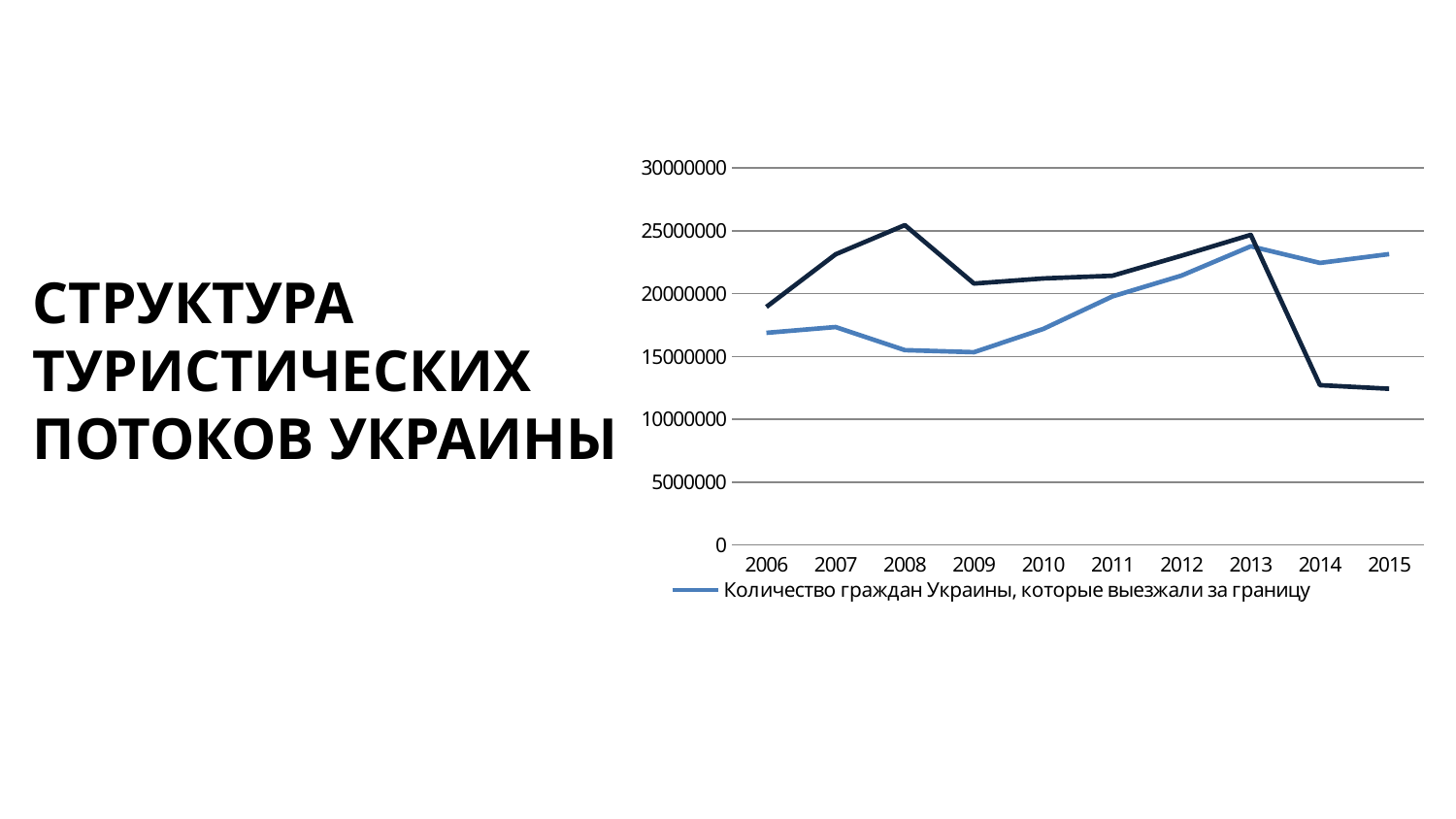
Is the value of 'Количество граждан Украины, которые выезжали за границу' for 2009 greater or less than 20000000? less Which year has the larger value of 'Количество граждан Украины, которые выезжали за границу', 2009 or 2013? 2013 Is the value of 'Количество граждан Украины, которые выезжали за границу' for 2006 greater or less than 20000000? less How many years are shown on the x axis of the chart? 10 What kind of chart is shown on the slide? line chart Which year has the larger value of 'Количество граждан Украины, которые выезжали за границу', 2006 or 2011? 2011 Is the value of 'Количество граждан Украины, которые выезжали за границу' for 2015 greater or less than 20000000? greater How many series does the chart's legend list? 1 In which year does 'Количество граждан Украины, которые выезжали за границу' reach its highest value? 2013 Does 'Количество граждан Украины, которые выезжали за границу' rise or fall from 2009 to 2013? rise What is the series name shown in the chart's legend? Количество граждан Украины, которые выезжали за границу